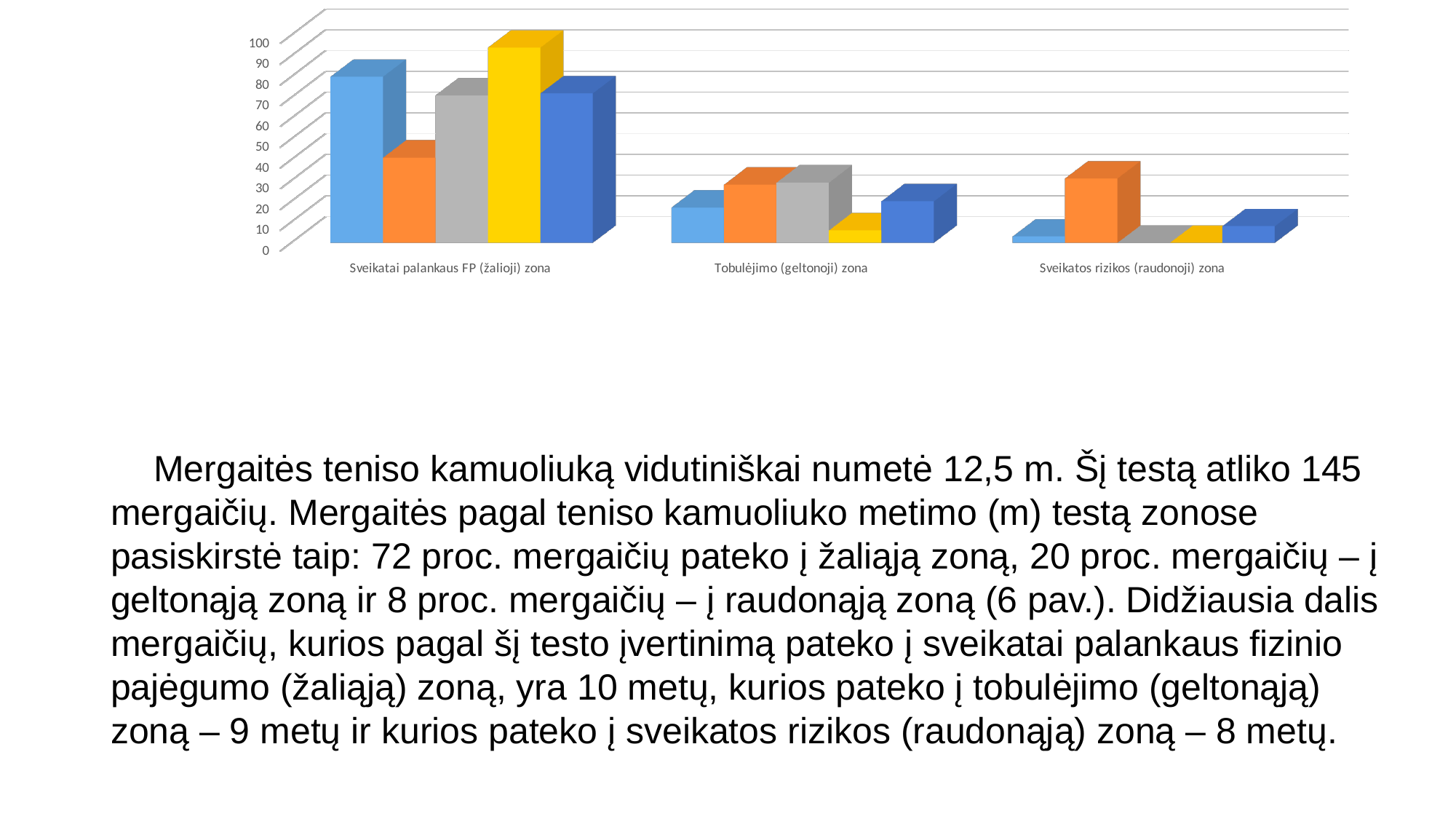
Is the orange bar in the 'Sveikatai palankaus FP (žalioji) zona' category greater or less than 60? less Is the orange bar in the 'Sveikatos rizikos (raudonoji) zona' category greater or less than 20? greater Is the yellow bar in the 'Sveikatai palankaus FP (žalioji) zona' category greater or less than 80? greater Do the bar heights generally rise or fall moving from the left category to the right category? fall How many bars are plotted for each category in the chart? 5 Which coloured bar is the highest in the 'Sveikatos rizikos (raudonoji) zona' category? orange Which coloured bar is the highest in the 'Sveikatai palankaus FP (žalioji) zona' category? yellow In the 'Sveikatai palankaus FP (žalioji) zona' category, which is larger: the light blue bar or the orange bar? the light blue bar What kind of chart is shown on the slide? bar chart Which category has the tallest bars overall in the chart? Sveikatai palankaus FP (žalioji) zona How many categories are shown on the x axis of the chart? 3